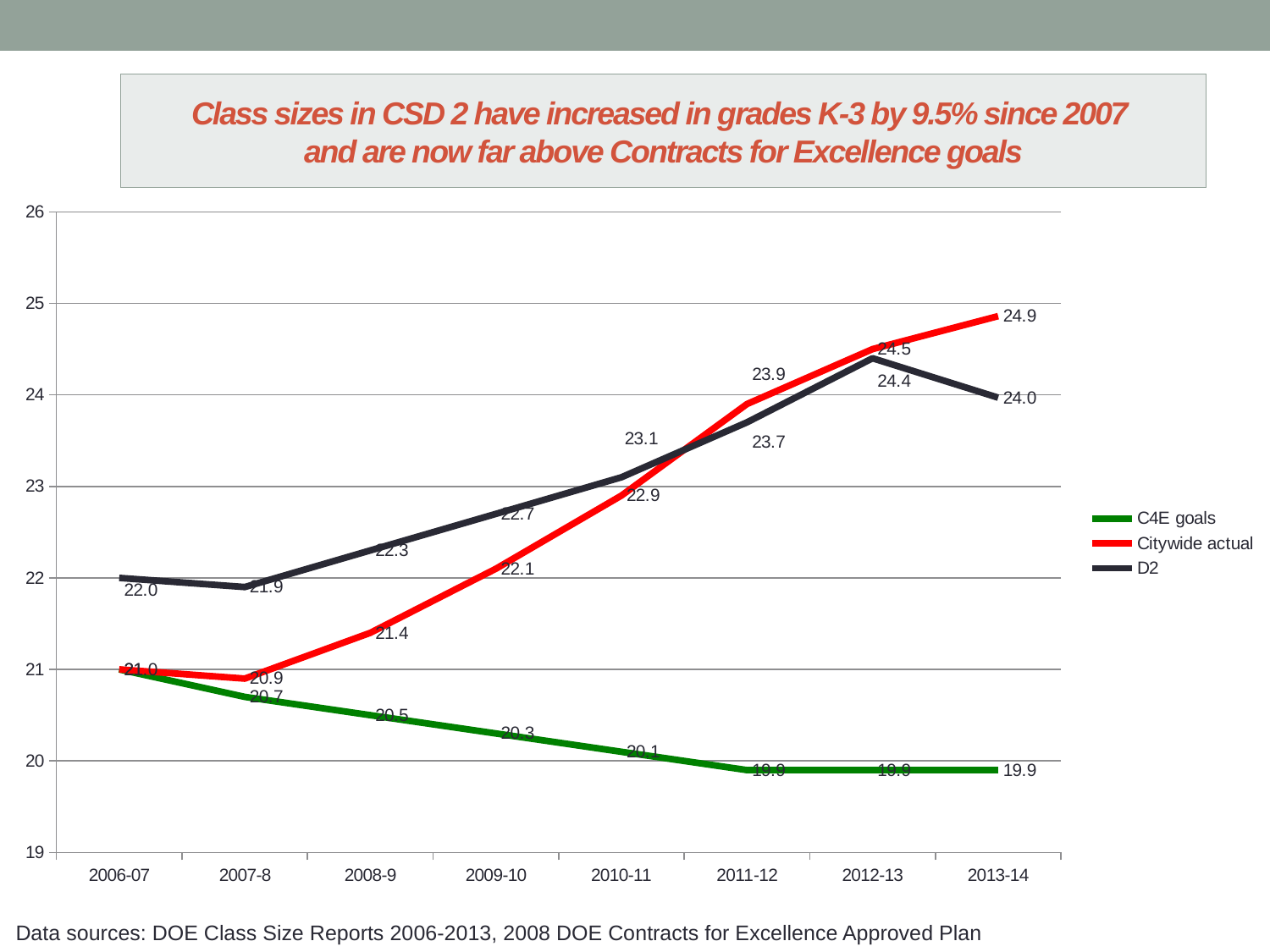
In 2013-14, what is the difference between the Citywide actual value and the C4E goals value? 5.0 Is the D2 value for 2009-10 greater or less than 23? less In 2013-14, which is larger: the Citywide actual value or the D2 value? Citywide actual What is the Citywide actual value for 2013-14? 24.9 How many school years are plotted along the x axis? 8 What is the Citywide actual value for 2011-12? 23.9 What is the D2 value for 2013-14? 24.0 In which school year does the D2 series reach its highest value? 2012-13 How many series does the legend list? 3 What is the D2 value for 2006-07? 22.0 What kind of chart is shown on the slide? Line chart Does the C4E goals series rise or fall from 2006-07 to 2013-14? Fall